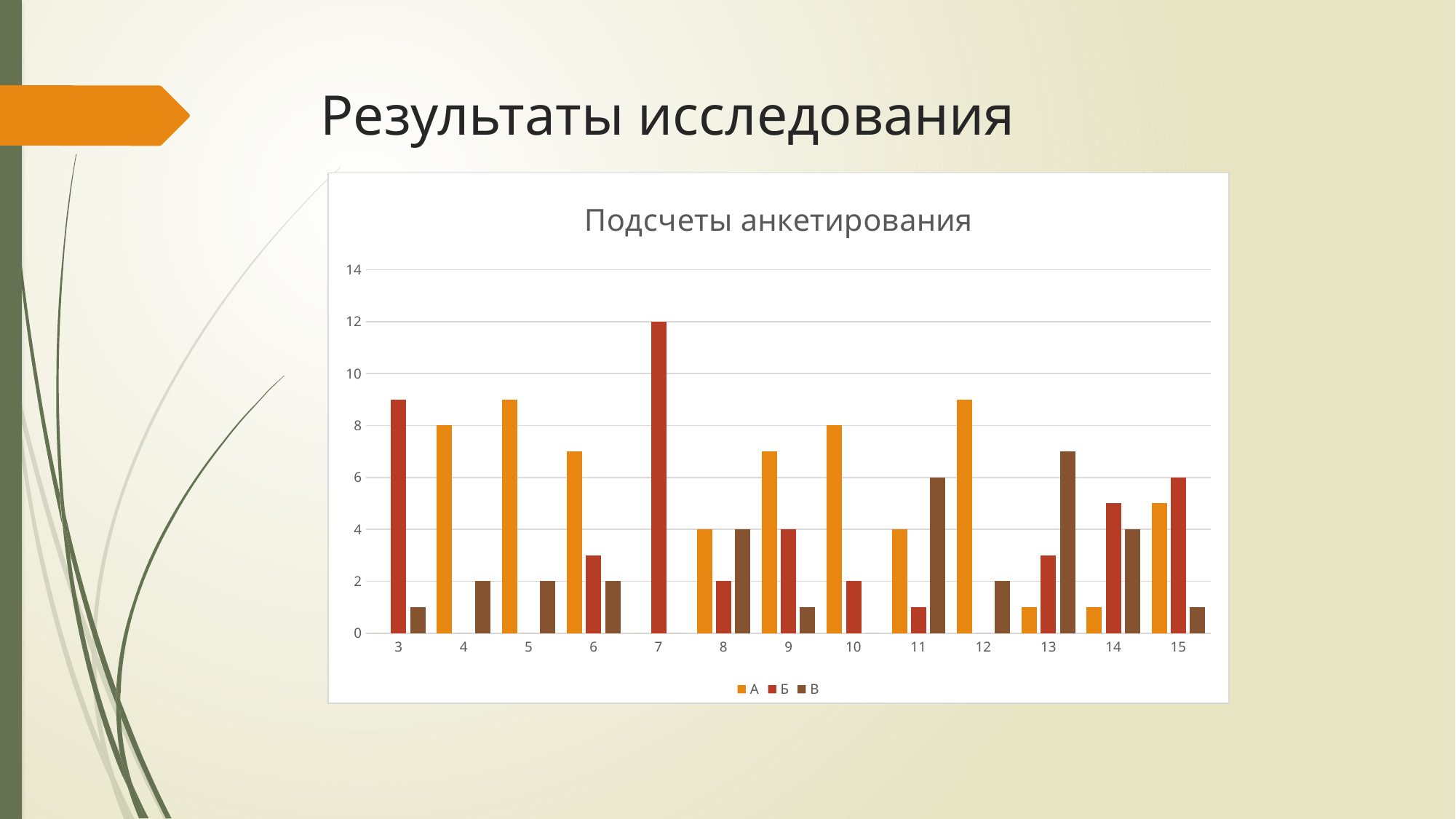
What is the value of series Б for category 7? 12 Which is larger for category 13: series Б or series В? В What is the value of series В for category 11? 6 What is the difference between series Б for category 7 and series А for category 10? 4 Is the value of series А for category 5 greater or less than 8? greater What is the value of series А for category 4? 8 What is the title of the chart? Подсчеты анкетирования How many categories are shown on the x axis? 13 Which category has the highest bar in the chart? 7 What is the value of series Б for category 15? 6 What kind of chart is shown on the slide? bar chart How many series does the legend list? 3